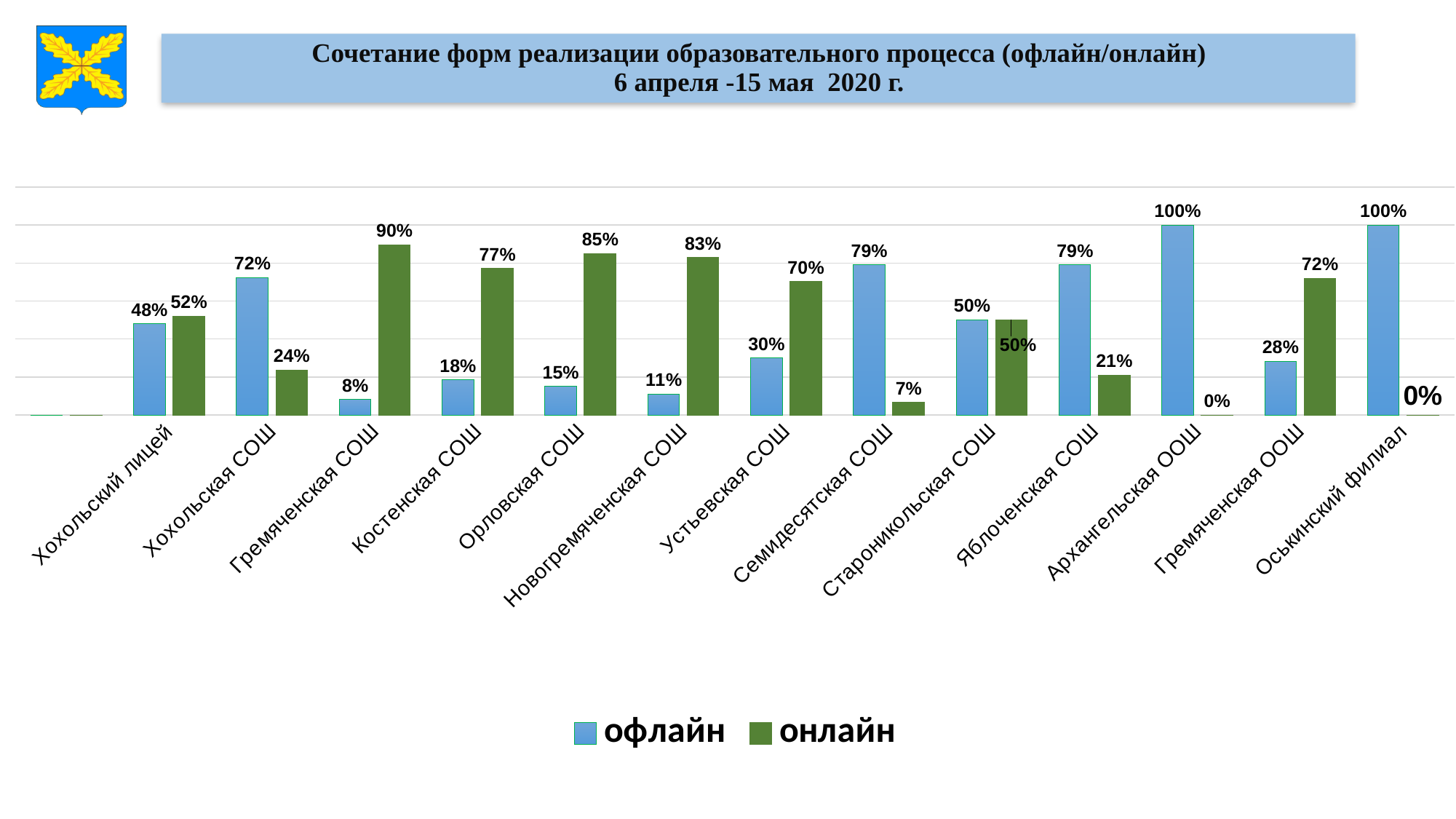
Which school has the lowest офлайн value? Гремяченская СОШ What is the офлайн value for Новогремяченская СОШ? 11% What is the онлайн value for Орловская СОШ? 85% What is the difference between the офлайн and онлайн values for Хохольская СОШ? 48% How many series does the legend list? 2 What is the онлайн value for Семидесятская СОШ? 7% What colour are the онлайн bars? green Which school has the highest онлайн value? Гремяченская СОШ For Устьевская СОШ, which is larger: the офлайн value or the онлайн value? онлайн What are the two entries in the chart legend? офлайн and онлайн What kind of chart is shown on the slide? bar chart What is the офлайн value for Хохольская СОШ? 72%